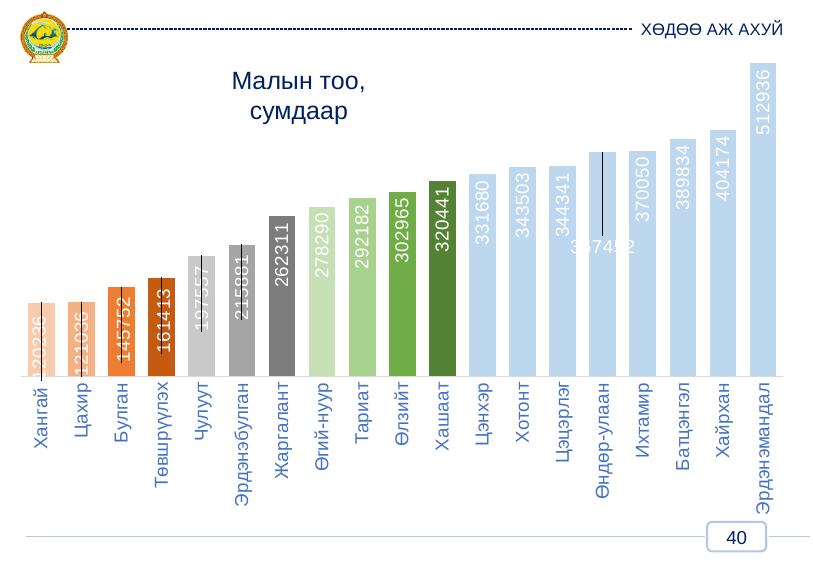
What kind of chart is shown on the slide? Bar chart How many soums are shown on the x axis of the chart? 19 Which soum has the highest value in the chart? Эрдэнэмандал What is the title of the chart? Малын тоо, сумдаар What is the value shown for Эрдэнэмандал? 512936 What is the value shown for Хашаат? 320441 What is the value shown for Жаргалант? 262311 What is the value shown for Булган? 145752 Which soum has the lowest value in the chart? Хангай What is the difference between the values for Эрдэнэмандал and Хайрхан? 108762 Which has a larger value, Тариат or Өлзийт? Өлзийт What is the difference between the values for Батцэнгэл and Ихтамир? 19784